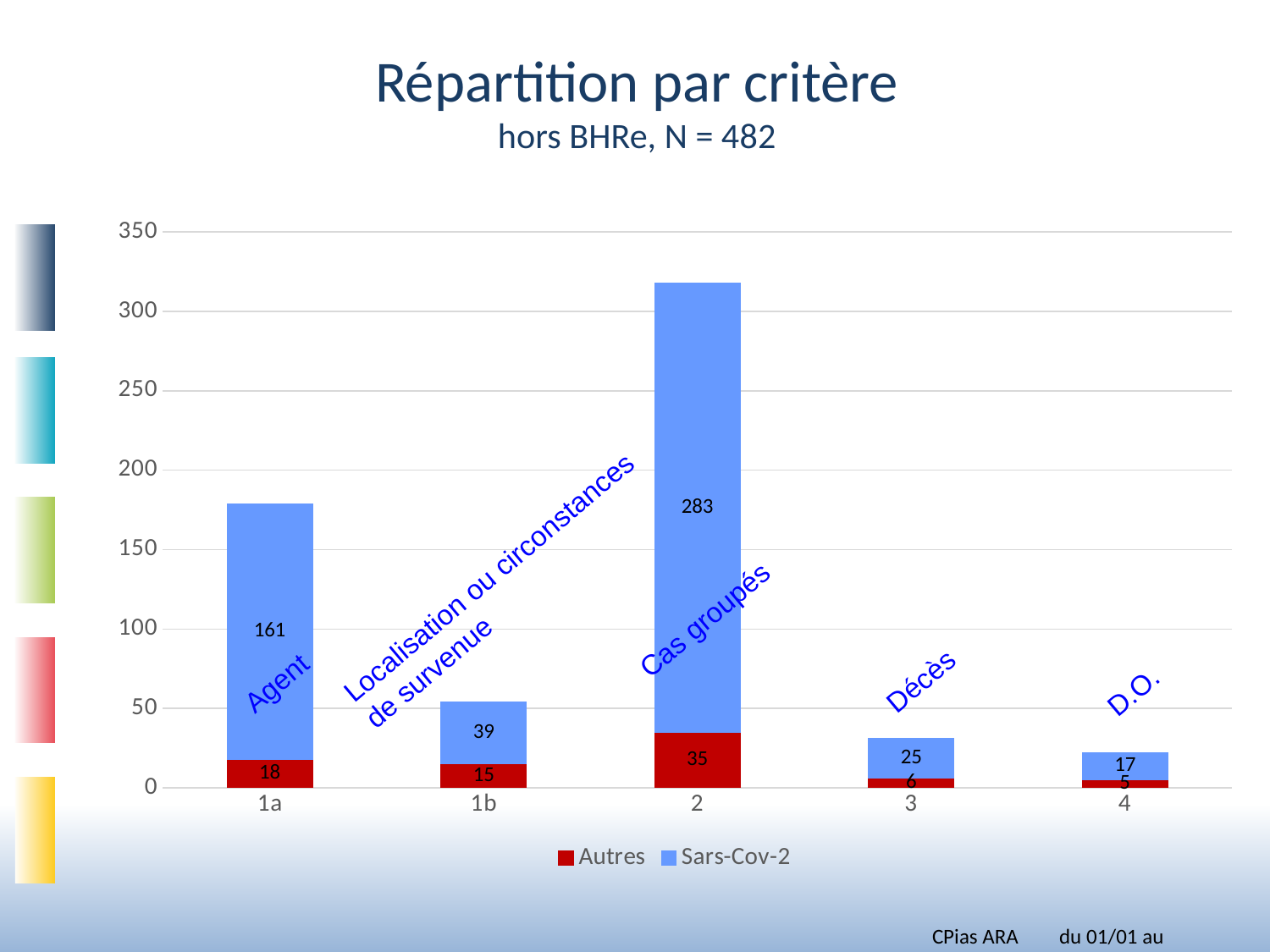
What is the difference between the Sars-Cov-2 values for categories 1a and 1b? 122 How many categories are shown on the x axis? 5 Which category has the highest Sars-Cov-2 value? 2 What is the Sars-Cov-2 value for category 1b? 39 What is the Sars-Cov-2 value for category 2? 283 How many series does the legend list? 2 Which is larger, the Autres value for category 2 or the Autres value for category 3? Category 2 What is the Autres value for category 4? 5 What is the total of the stacked bar for category 3? 31 Which category has the lowest Autres value? 4 What is the Autres value for category 1a? 18 What is the total of the stacked bar for category 1a? 179